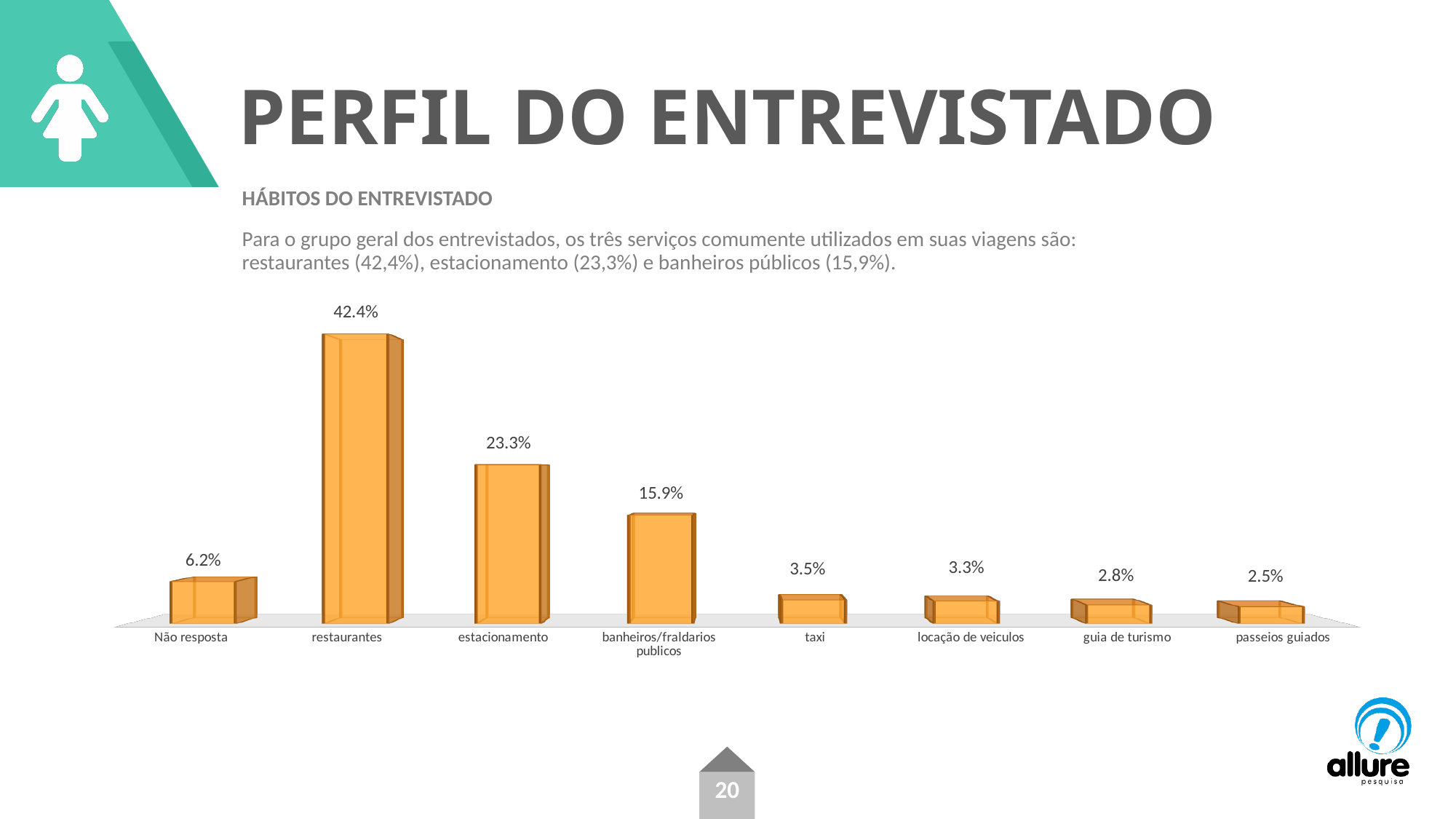
What is the value for banheiros/fraldarios publicos? 15.9% What is the value for restaurantes? 42.4% What is the difference between the values for restaurantes and estacionamento? 19.1% What is the value for estacionamento? 23.3% What kind of chart is shown on the slide? bar chart How many categories are shown in the chart? 8 What is the difference between the values for estacionamento and banheiros/fraldarios publicos? 7.4% Which category has the highest value? restaurantes What is the value for Não resposta? 6.2% Which category has the lowest value? passeios guiados What is the value for taxi? 3.5% Which is larger, the value for locação de veiculos or the value for guia de turismo? locação de veiculos